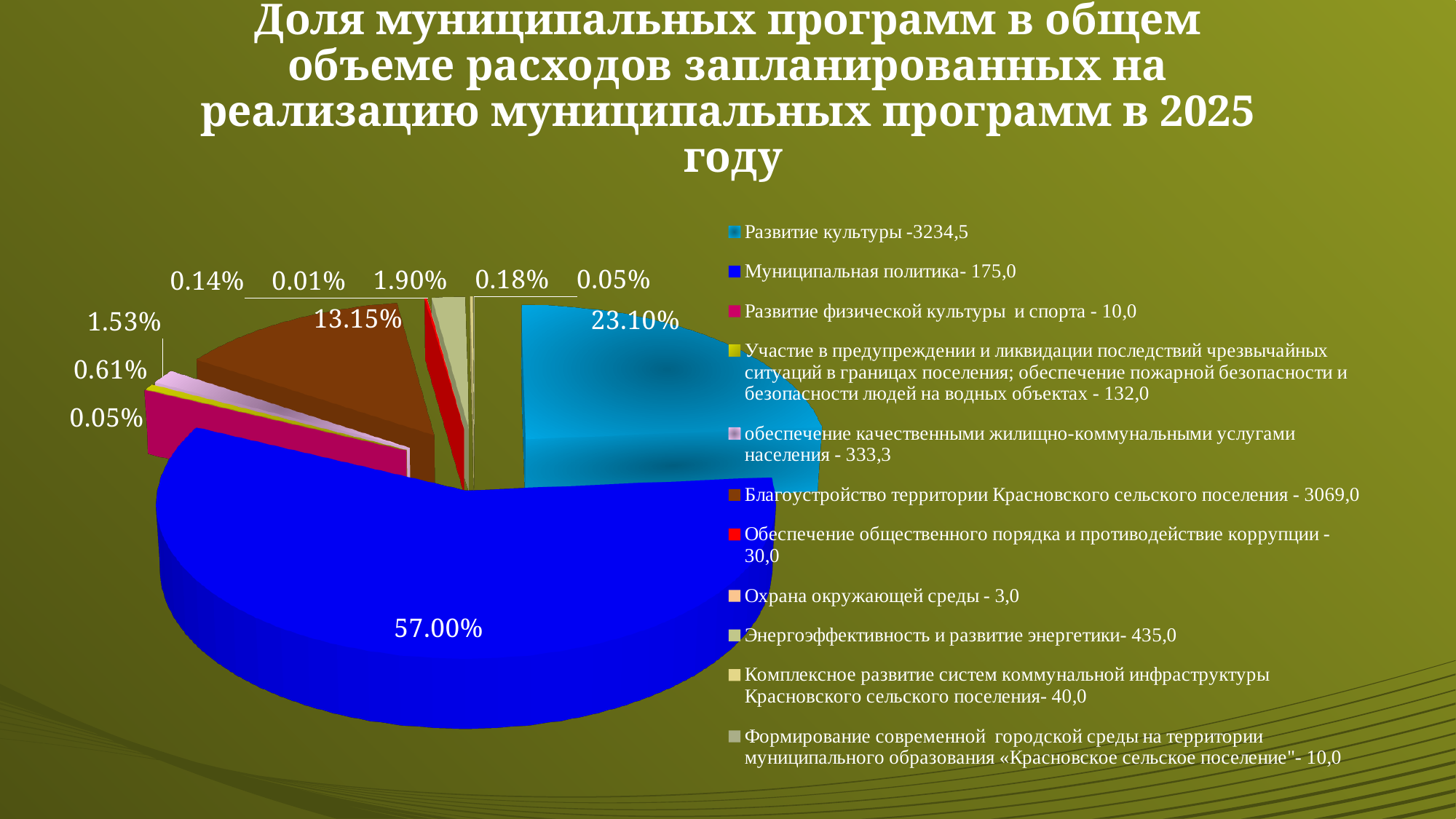
What is the smallest percentage label shown on the pie chart? 0.01% What percentage is shown for the largest slice (Муниципальная политика)? 57.00% What is the difference in percentage points between the Муниципальная политика slice and the Развитие культуры slice? 33.90% What colour is the slice for Муниципальная политика? blue What kind of chart is shown on the slide? pie chart Which slice is larger: Развитие культуры or Благоустройство территории Красновского сельского поселения? Развитие культуры Which category has the largest slice of the pie? Муниципальная политика What percentage is shown for the slice for Благоустройство территории Красновского сельского поселения? 13.15% What is the difference in percentage points between the Развитие культуры slice and the Благоустройство территории Красновского сельского поселения slice? 9.95% How many entries does the legend list? 11 What percentage is shown for the slice for Развитие культуры? 23.10% What value is listed in the legend for Энергоэффективность и развитие энергетики? 435,0